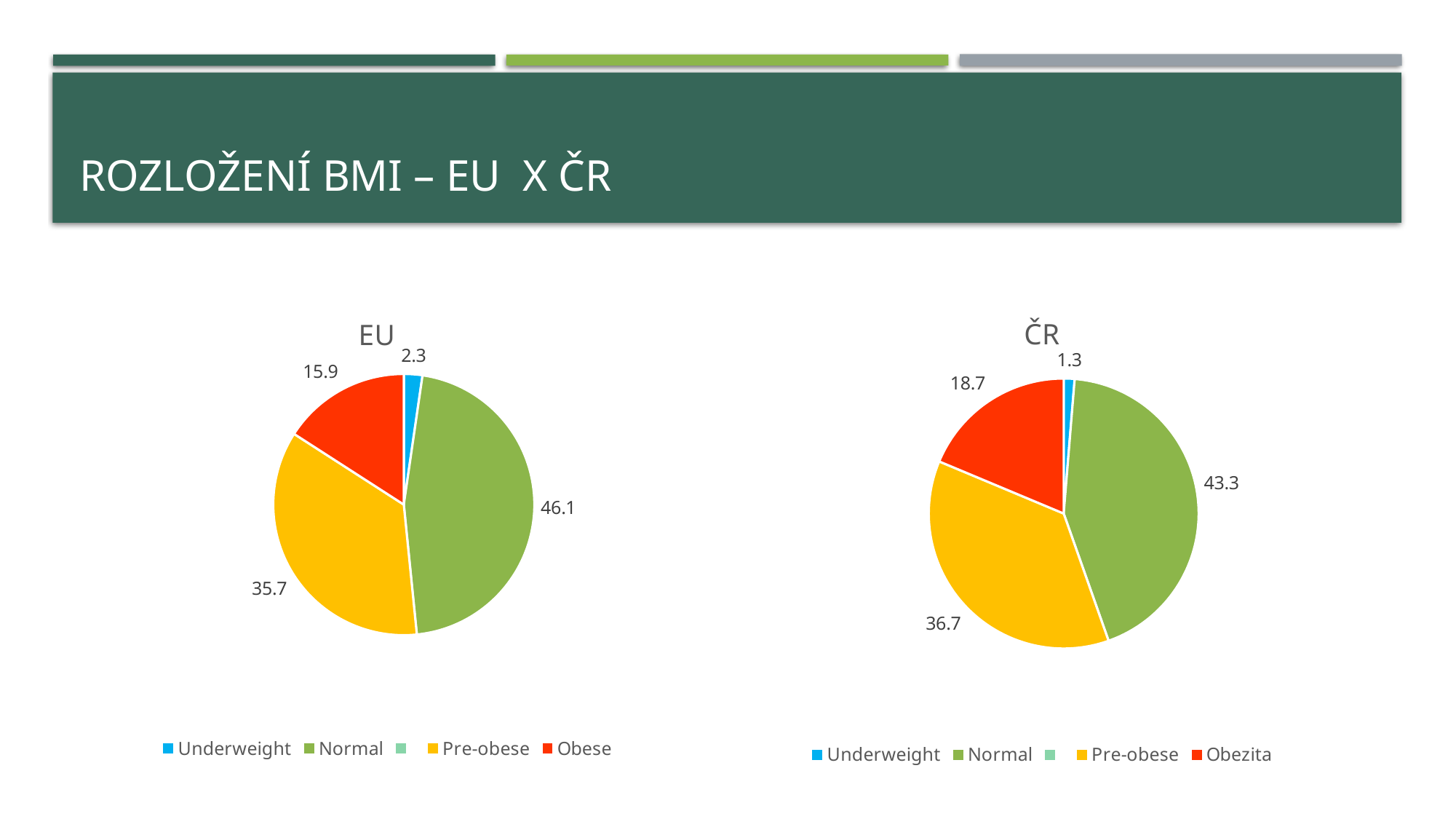
In the EU pie chart, which category has the largest slice? Normal In the ČR pie chart, which category has the smallest slice? Underweight In the EU pie chart, what is the value for Underweight? 2.3 In the ČR pie chart, what is the value for Obezita? 18.7 Which is larger: the Obese value in the EU chart or the Obezita value in the ČR chart? Obezita in the ČR chart What is the title of the slide? ROZLOŽENÍ BMI – EU X ČR In the EU pie chart, what is the value for Normal? 46.1 What type of chart is used for the EU data? Pie chart In the ČR pie chart, what is the value for Pre-obese? 36.7 In the EU pie chart, what is the difference between the Normal and Pre-obese values? 10.4 How many slices are shown in the ČR pie chart? 4 In the ČR pie chart, what is the difference between the Obezita and Underweight values? 17.4